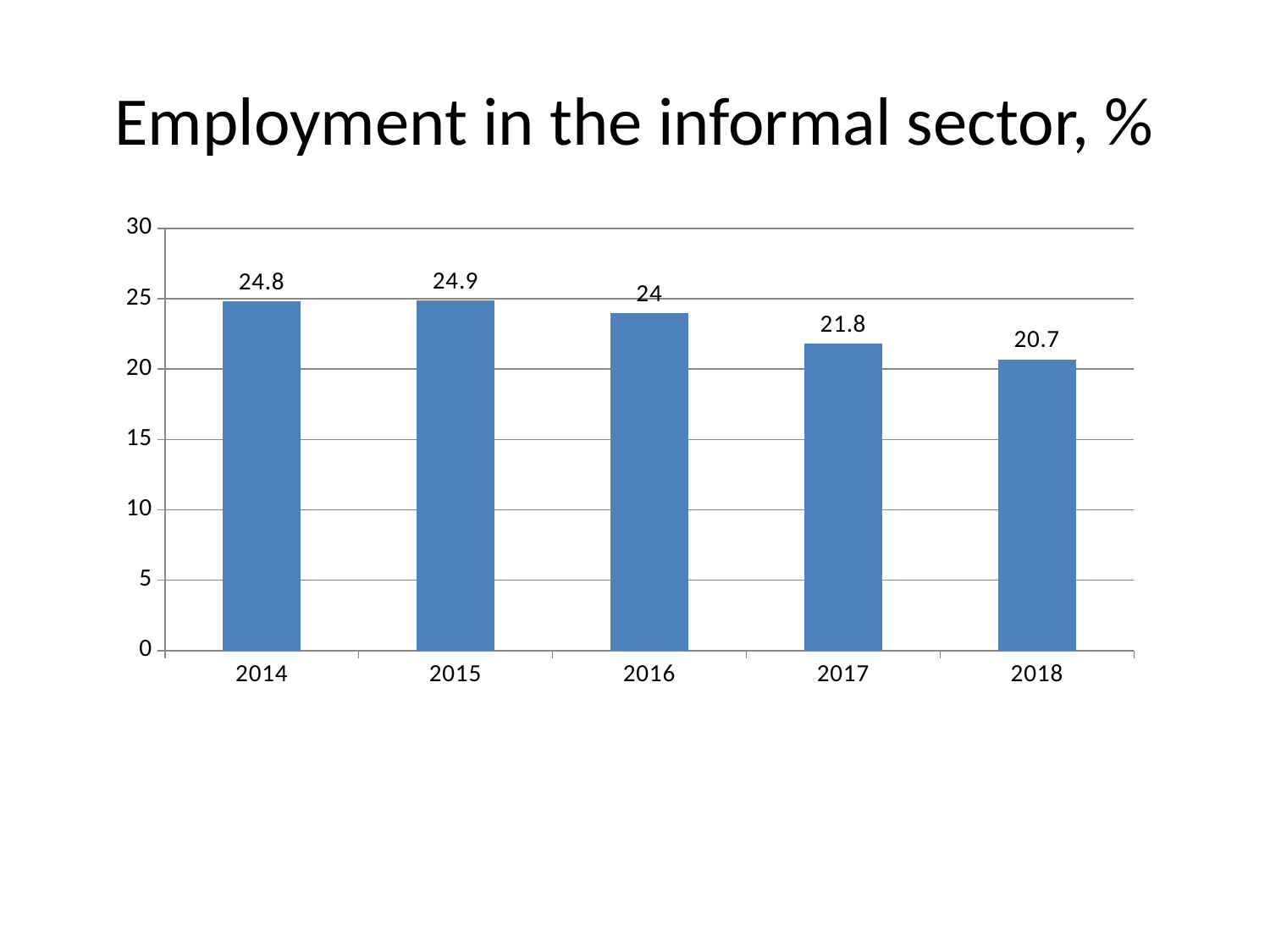
What is the difference between the values for 2016 and 2017? 2.2 Which year has the lowest value? 2018 Which year has the highest value? 2015 What kind of chart is shown on the slide? bar chart Is the value for 2017 greater or less than 25? less Which is larger, the value for 2016 or the value for 2017? 2016 What is the value for 2014? 24.8 Do the values rise or fall from 2015 to 2018? fall How many years are shown on the chart? 5 What is the value for 2018? 20.7 What is the difference between the values for 2014 and 2018? 4.1 What is the value for 2016? 24